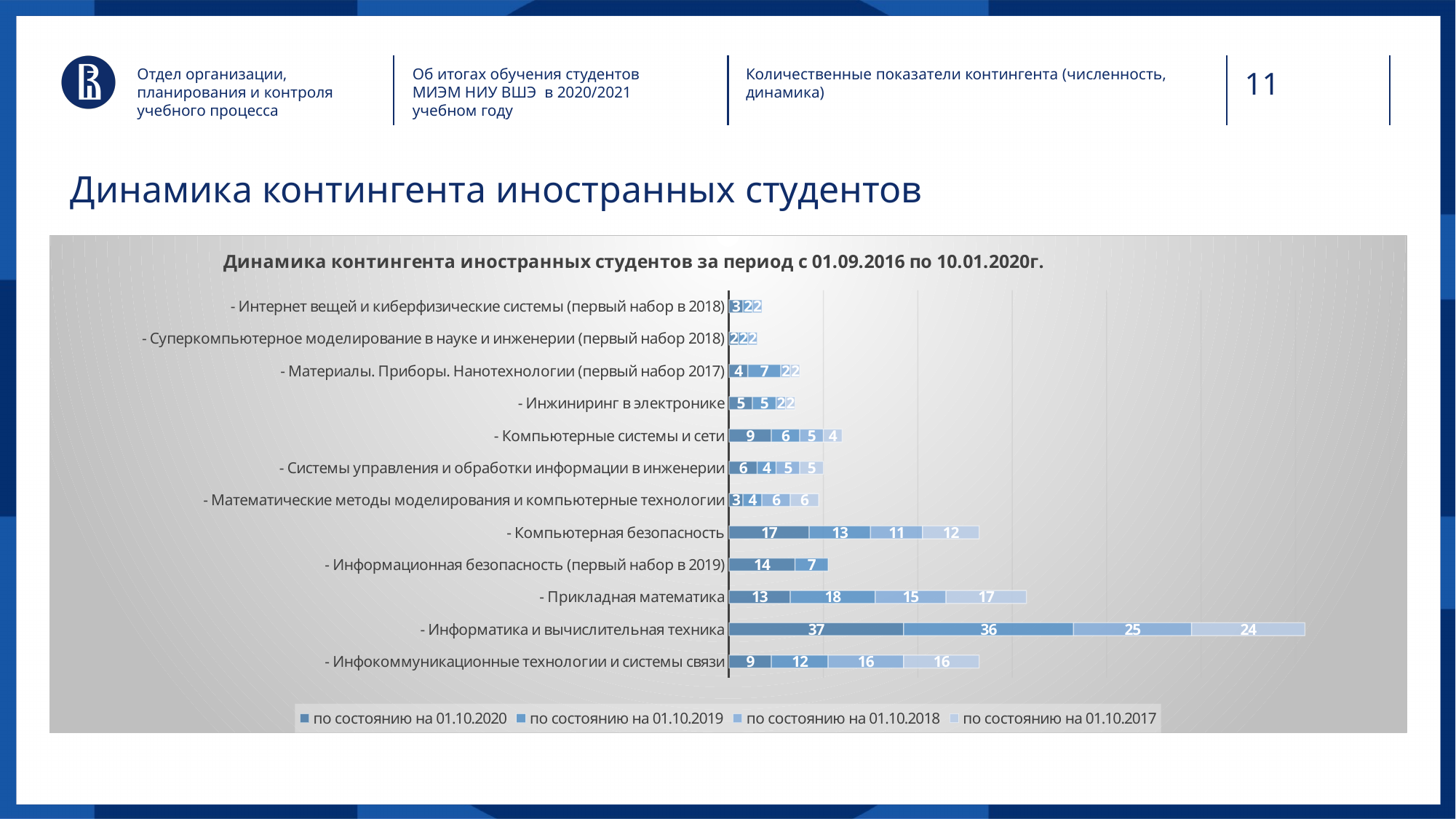
What is the total of the stacked bar for Инфокоммуникационные технологии и системы связи? 53 What is the value for Информатика и вычислительная техника in the series по состоянию на 01.10.2020? 37 In the series по состоянию на 01.10.2020, which is larger: Компьютерные системы и сети or Математические методы моделирования и компьютерные технологии? Компьютерные системы и сети What is the value for Прикладная математика in the series по состоянию на 01.10.2019? 18 What kind of chart is shown on the slide? bar chart What is the value for Компьютерная безопасность in the series по состоянию на 01.10.2017? 12 What is the total of the stacked bar for Информатика и вычислительная техника? 122 What is the difference between the 01.10.2020 and 01.10.2019 values for Информационная безопасность (первый набор в 2019)? 7 How many categories (programmes) are plotted on the chart? 12 Which category has the highest value in the series по состоянию на 01.10.2020? Информатика и вычислительная техника What is the title of the chart? Динамика контингента иностранных студентов за период с 01.09.2016 по 10.01.2020г. How many series does the legend list? 4